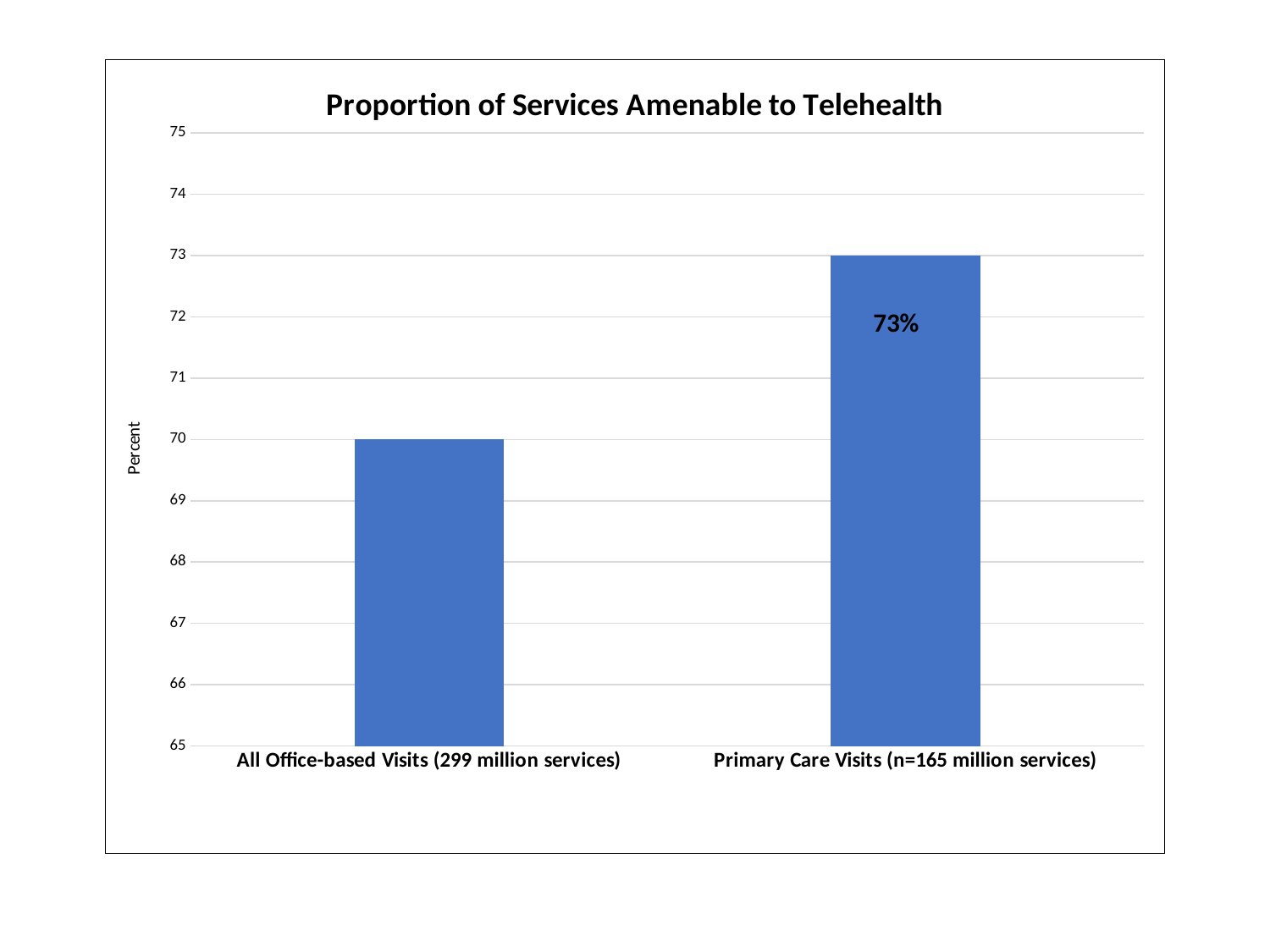
What is the label on the y axis? Percent How many categories are shown on the x axis? 2 What value does the bar for All Office-based Visits (299 million services) reach on the y axis? 70 What kind of chart is shown on the slide? Bar chart Which category has the lowest value? All Office-based Visits (299 million services) What is the value for Primary Care Visits (n=165 million services)? 73% Is the value for All Office-based Visits (299 million services) greater or less than 68? greater Is the value for Primary Care Visits (n=165 million services) greater or less than 74? less Which category has the highest value? Primary Care Visits (n=165 million services) What is the title of the chart? Proportion of Services Amenable to Telehealth By how many percentage points does the value for Primary Care Visits exceed the value for All Office-based Visits? 3 Which is larger, the value for All Office-based Visits or the value for Primary Care Visits? Primary Care Visits